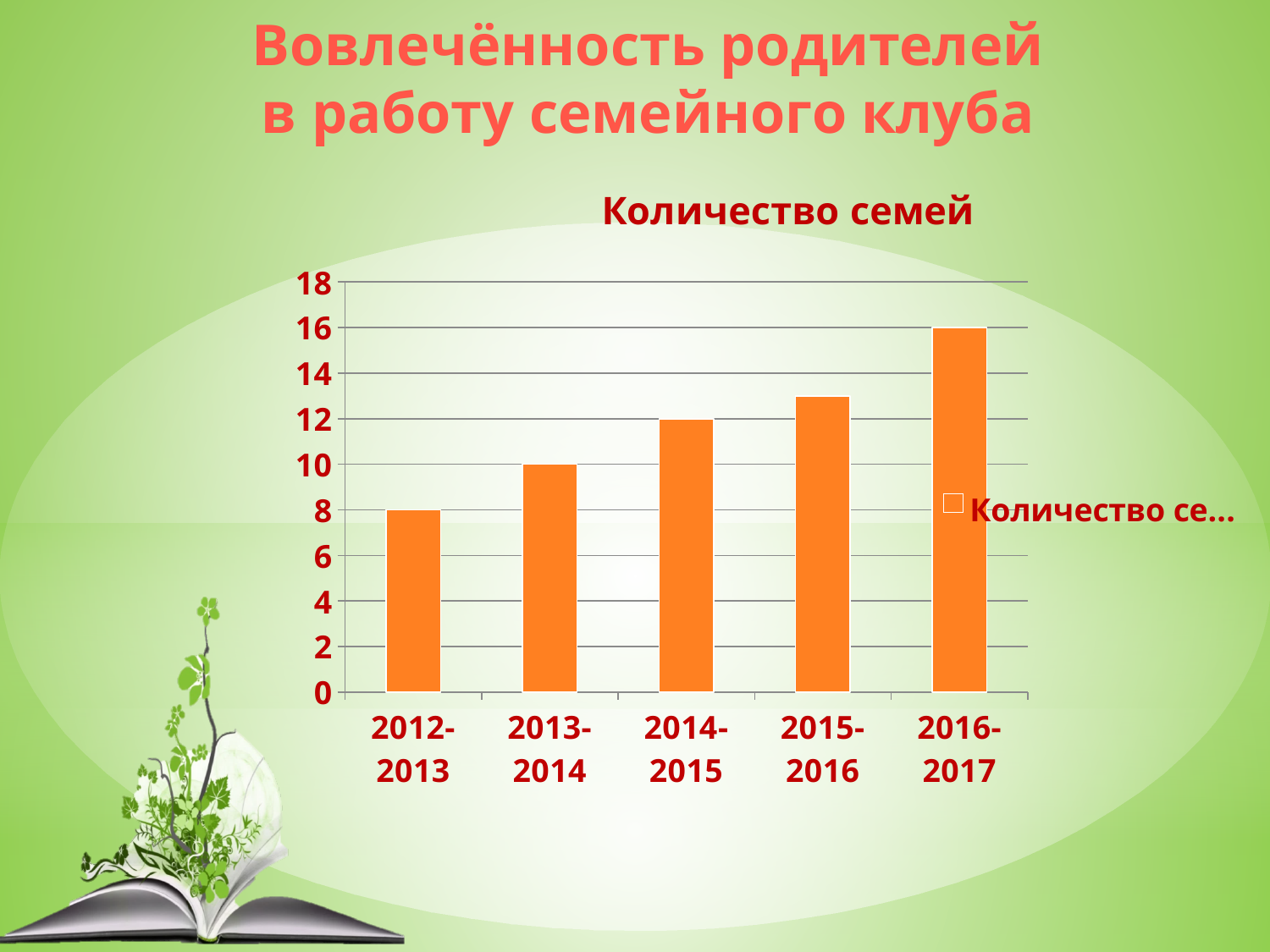
What is the value for 2014-2015? 12 What is the value for 2016-2017? 16 What is the value for 2012-2013? 8 What is the chart's title? Количество семей What type of chart is shown on the slide? bar chart Do the values rise or fall from 2012-2013 to 2016-2017? rise Is the value for 2015-2016 greater or less than 12? greater Which school year has the highest value? 2016-2017 How many categories (school years) are shown on the x axis? 5 What is the difference between the values for 2016-2017 and 2012-2013? 8 What is the value for 2013-2014? 10 Which school year has the lowest value? 2012-2013